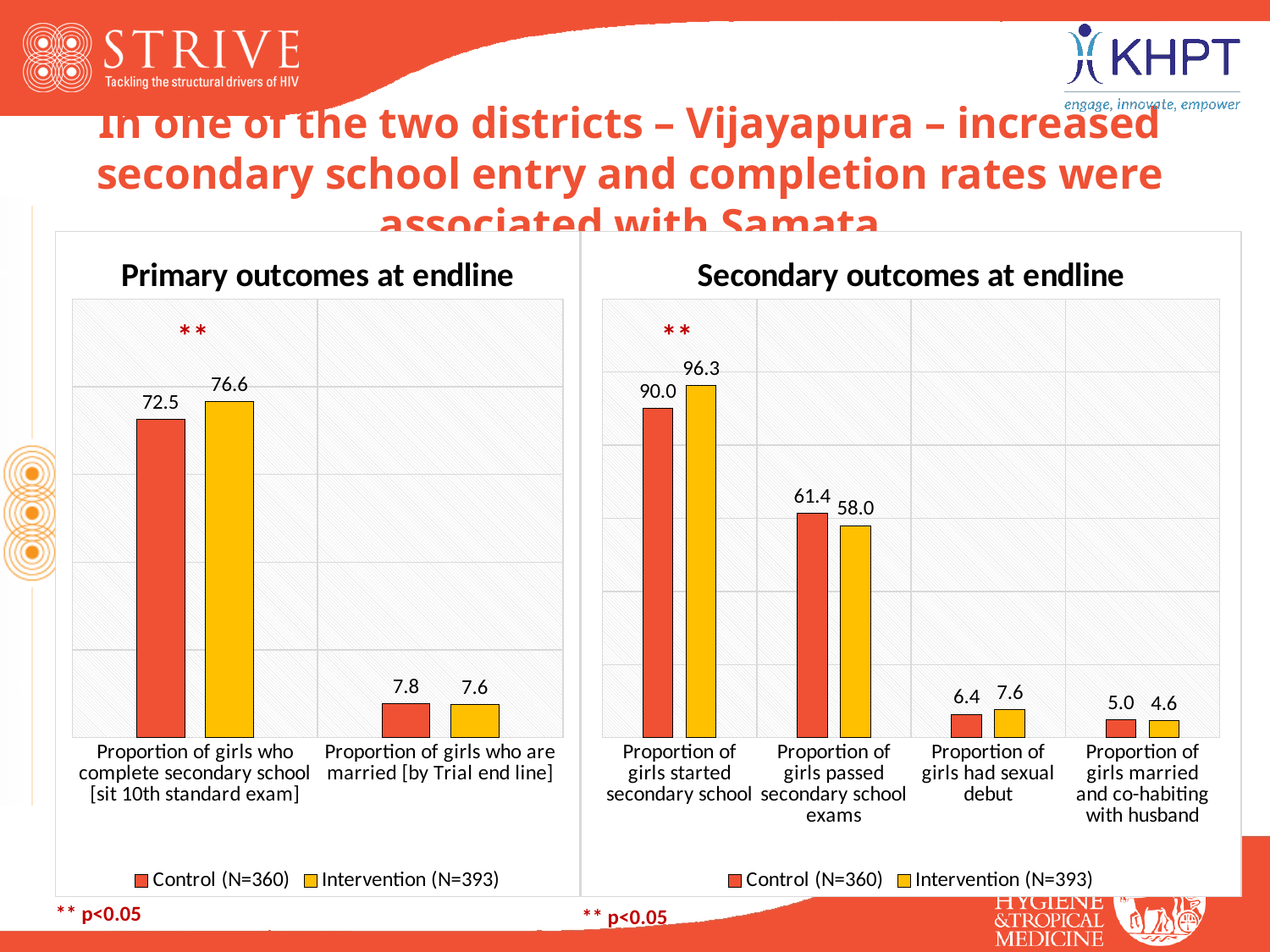
In the 'Secondary outcomes at endline' chart, which category has the highest Control value? Proportion of girls started secondary school In the 'Secondary outcomes at endline' chart, what is the Control value for the proportion of girls passed secondary school exams? 61.4 What type of chart is the 'Primary outcomes at endline' chart? Bar chart How many categories are shown in the 'Secondary outcomes at endline' chart? 4 In the 'Secondary outcomes at endline' chart, what is the Intervention value for the proportion of girls started secondary school? 96.3 In the 'Primary outcomes at endline' chart, what is the Intervention value for the proportion of girls who are married [by Trial end line]? 7.6 In the 'Secondary outcomes at endline' chart, what is the difference between the Intervention and Control values for the proportion of girls had sexual debut? 1.2 In the 'Primary outcomes at endline' chart, what is the Control value for the proportion of girls who complete secondary school [sit 10th standard exam]? 72.5 In the 'Primary outcomes at endline' chart, how many series does the legend list? 2 In the 'Secondary outcomes at endline' chart, which category has the lowest Intervention value? Proportion of girls married and co-habiting with husband In the 'Secondary outcomes at endline' chart, which is larger for the proportion of girls passed secondary school exams: Control or Intervention? Control In the 'Primary outcomes at endline' chart, what is the difference between the Intervention and Control values for the proportion of girls who complete secondary school? 4.1